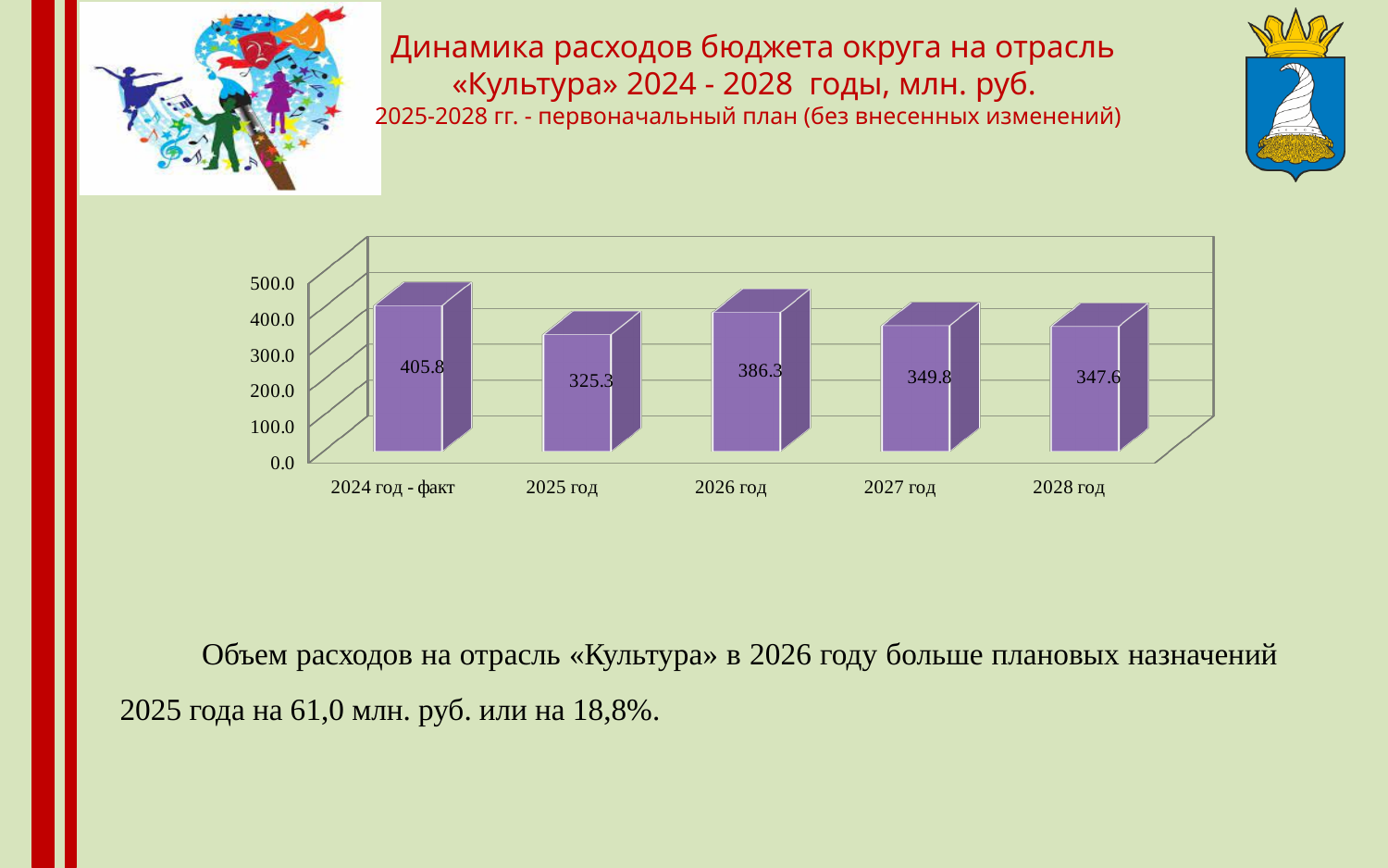
What is the difference between the values for 2026 год and 2025 год? 61.0 What is the value for 2024 год - факт? 405.8 Which category has the lowest value? 2025 год Which category has the highest value? 2024 год - факт How many categories are shown on the x axis? 5 What is the difference between the values for 2024 год - факт and 2026 год? 19.5 Is the value for 2025 год greater or less than 300.0? greater Which is larger, the value for 2024 год - факт or the value for 2025 год? 2024 год - факт What is the value for 2028 год? 347.6 What is the value for 2026 год? 386.3 What is the value for 2025 год? 325.3 What kind of chart is shown on the slide? bar chart